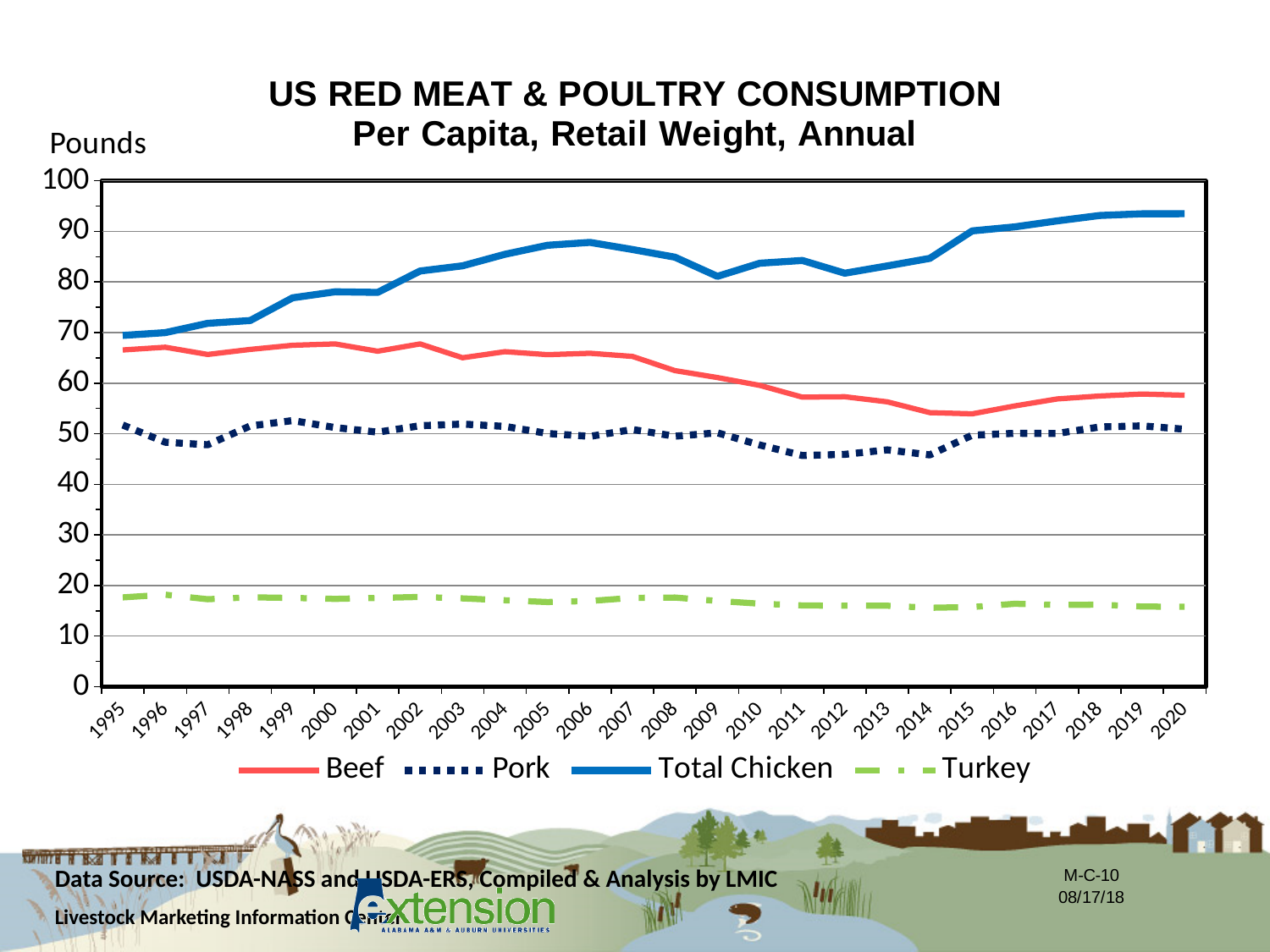
Is the value for Turkey in 1995 greater or less than 20? less What kind of chart is shown on the slide? line chart Which series has the highest value in 2020? Total Chicken How many series does the legend list? 4 Which is larger in 2000, Beef or Pork? Beef Which series has the lowest value in 2020? Turkey Is the value for Pork in 2011 greater or less than 50? less What unit is shown on the y axis label? Pounds How many years are plotted along the x axis? 26 Is the value for Total Chicken in 2020 greater or less than 90? greater Does the Total Chicken series rise or fall from 1995 to 2020? rise